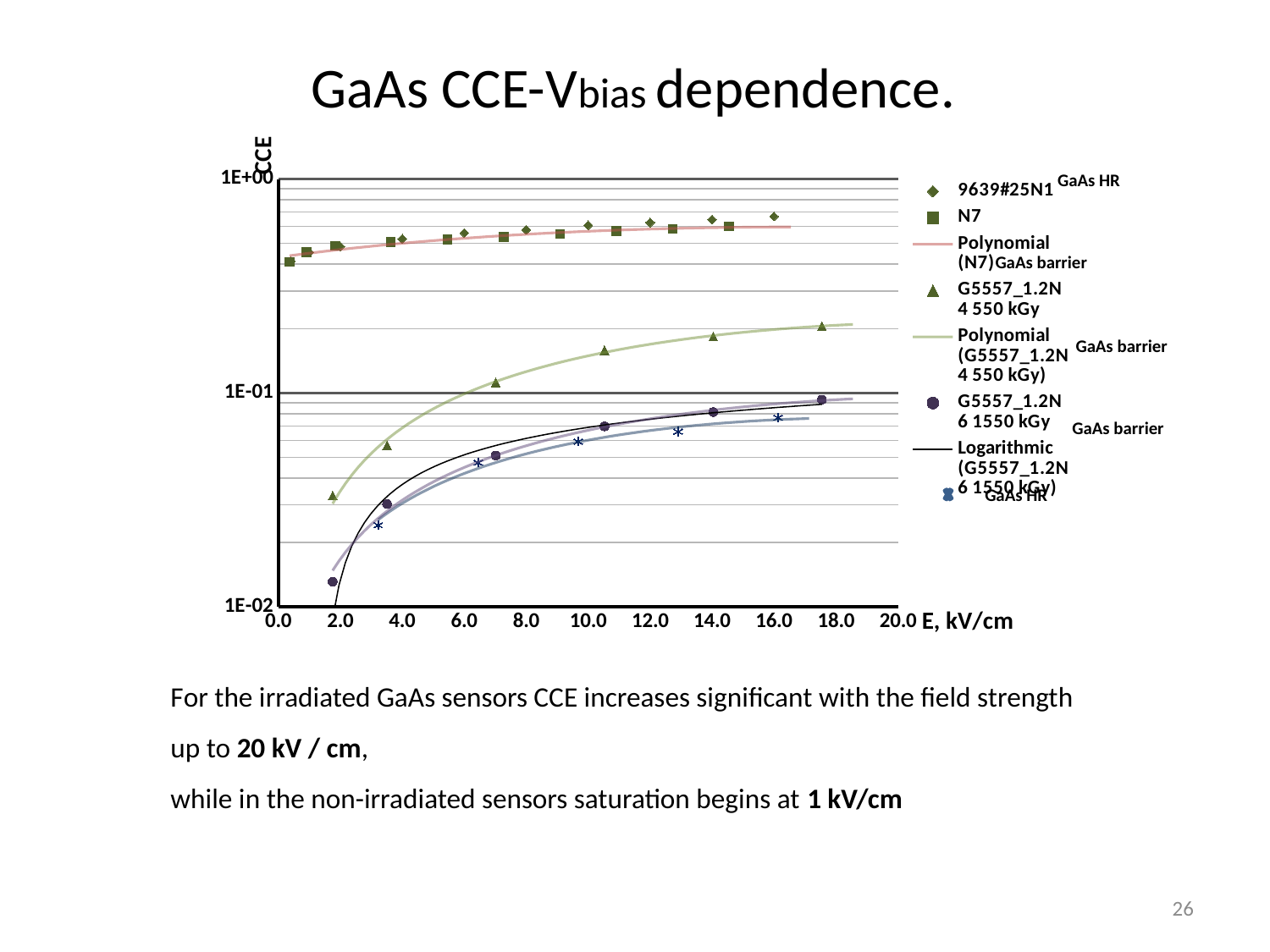
Which series has the lowest CCE values at high field strength (around 18 kV/cm): N7 or G5557_1.2N 6 1550 kGy? G5557_1.2N 6 1550 kGy Is the CCE value for the G5557_1.2N 4 550 kGy series at about 18.0 kV/cm greater or less than 1E-01? greater Is the CCE value for the G5557_1.2N 6 1550 kGy series at about 2.0 kV/cm greater or less than 1E-01? less What is the label of the y axis of the chart? CCE What is the label of the x axis of the chart? E, kV/cm At about 7 kV/cm, which series has the larger CCE: G5557_1.2N 4 550 kGy or G5557_1.2N 6 1550 kGy? G5557_1.2N 4 550 kGy What kind of chart is shown on the slide? Scatter chart with fitted trend lines Does the CCE of the G5557_1.2N 4 550 kGy series rise or fall as E increases? rise At about 10 kV/cm, which series has the larger CCE: N7 or G5557_1.2N 4 550 kGy? N7 Which series contains the lowest plotted CCE point on the chart? G5557_1.2N 6 1550 kGy Does the CCE of the G5557_1.2N 6 1550 kGy series rise or fall as E increases? rise Are the CCE values of the N7 series greater or less than 1E-01? greater